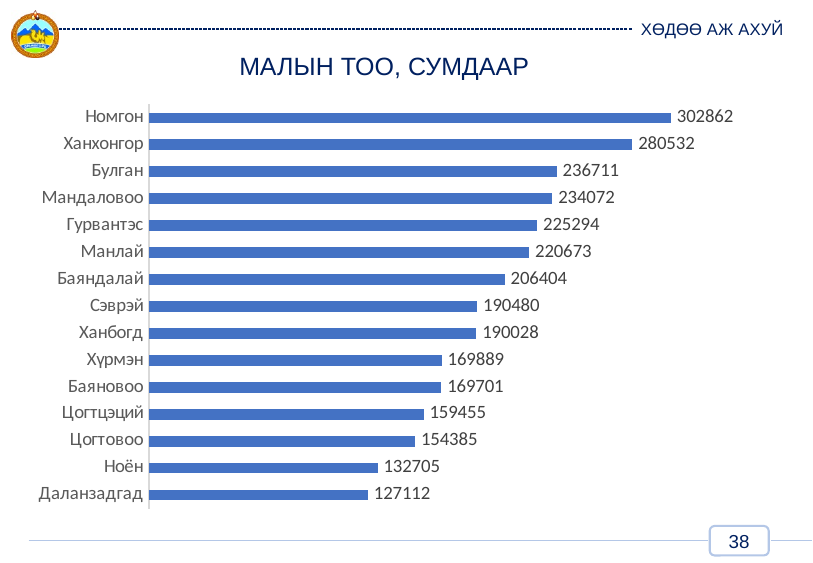
What is the value for Номгон? 302862 Which is larger, the value for Цогтцэций or the value for Баяндалай? Баяндалай Which is larger, the value for Булган or the value for Манлай? Булган What is the difference between the values for Ноён and Даланзадгад? 5593 What kind of chart is shown on the slide? Bar chart What is the value for Цогтовоо? 154385 Which category has the lowest value? Даланзадгад How many categories are shown in the chart? 15 What is the difference between the values for Номгон and Ханхонгор? 22330 What is the title of the chart? МАЛЫН ТОО, СУМДААР What is the value for Ханбогд? 190028 Which category has the highest value? Номгон